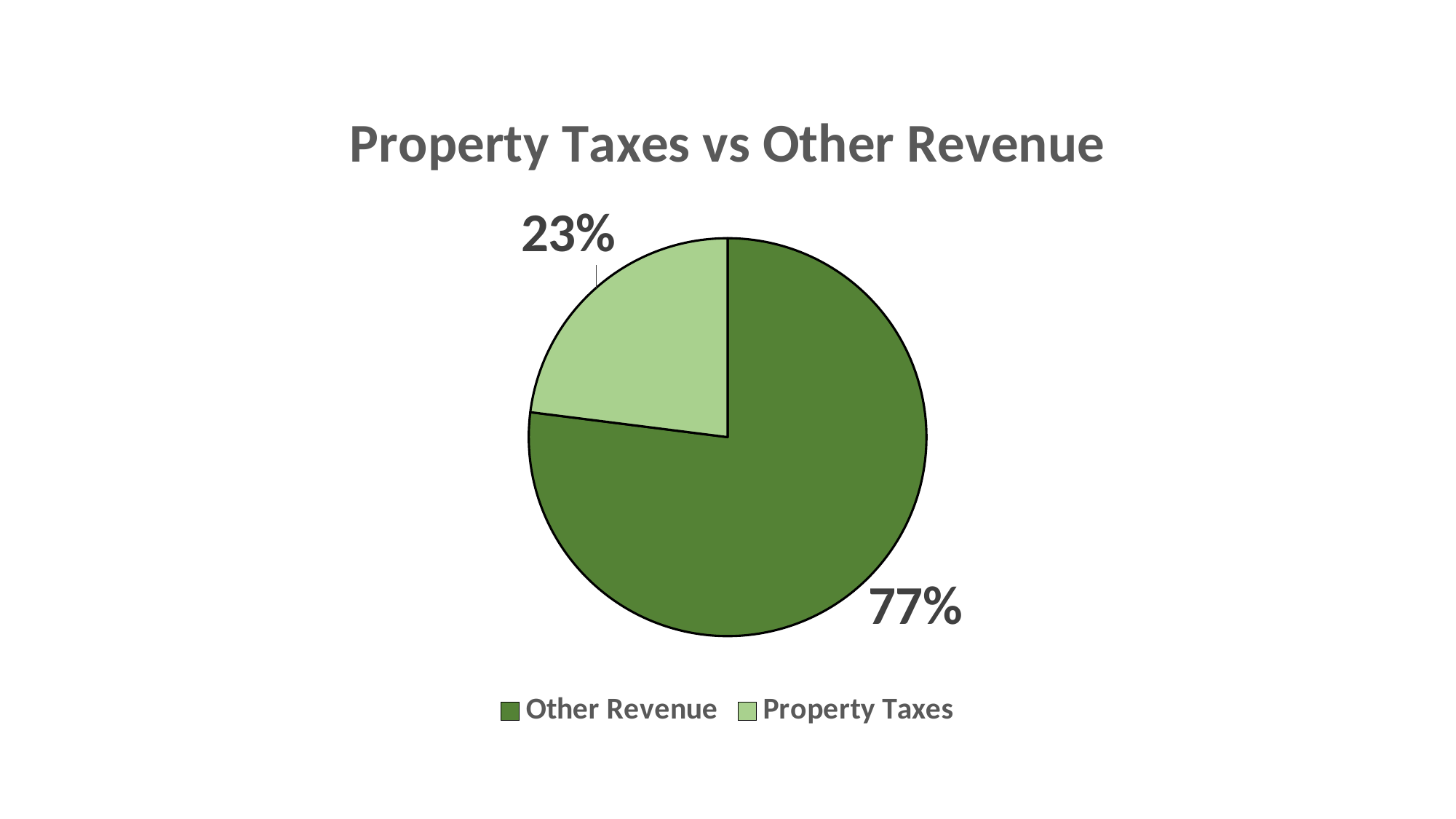
How many slices does the pie chart have? 2 Which slice is the smallest? Property Taxes What is the difference in percentage points between Other Revenue and Property Taxes? 54 What share of the pie is Other Revenue? 77% What share of the pie is Property Taxes? 23% Which slice is the largest? Other Revenue How many entries does the legend list? 2 What kind of chart is shown on the slide? Pie chart What is the title of the chart? Property Taxes vs Other Revenue Which slice is shown in the lighter green colour? Property Taxes Which is larger, Property Taxes or Other Revenue? Other Revenue